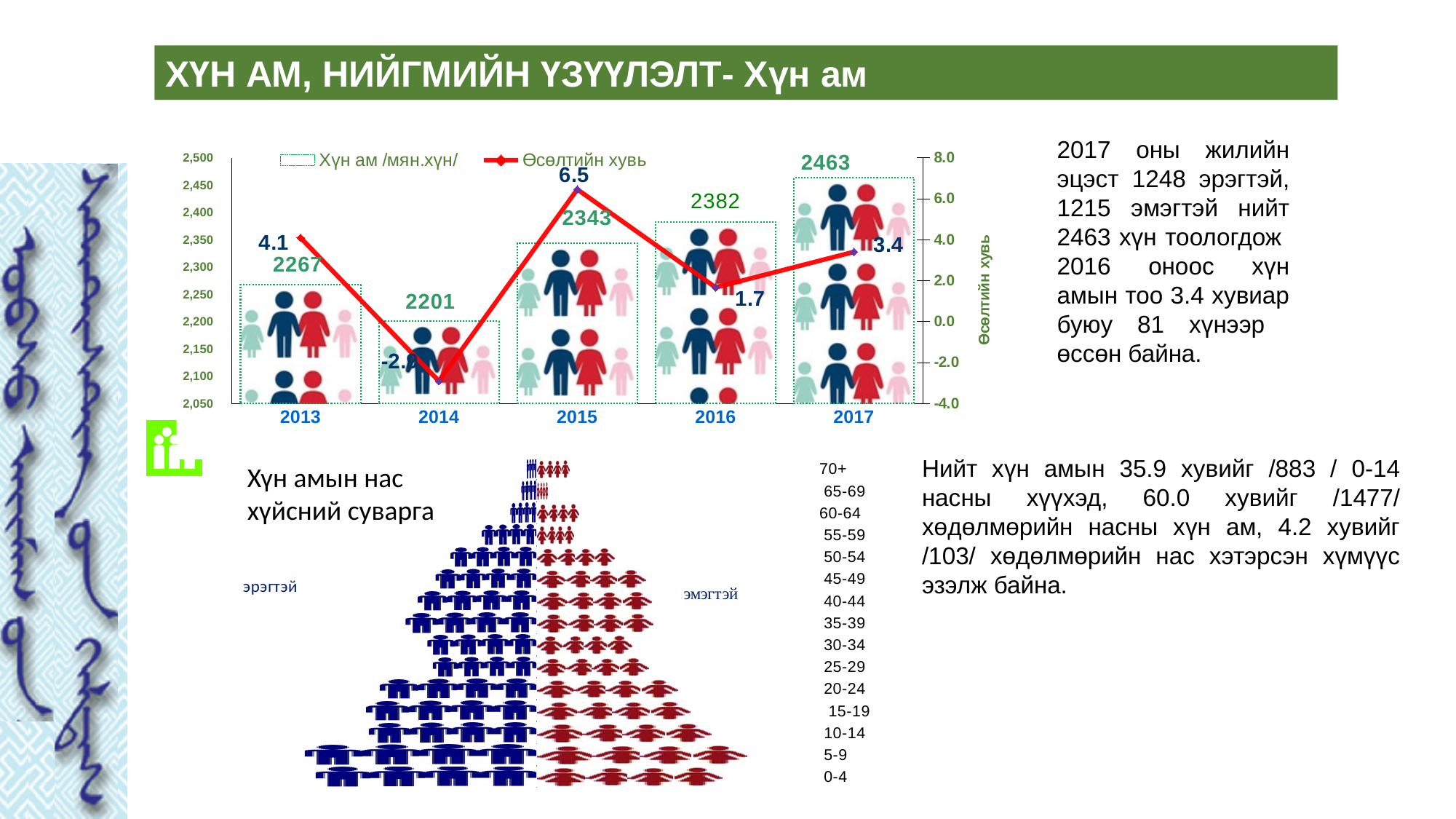
In the top chart, what is the population value for 2014? 2201 How many years are shown on the x axis of the top chart? 5 In the top chart, what is the difference between the population values for 2017 and 2016? 81 In the top chart, which year has the larger population value, 2013 or 2014? 2013 In the top chart, what is the growth rate (Өсөлтийн хувь) for 2015? 6.5 In the top chart, what is the population (Хүн ам /мян.хүн/) value for 2017? 2463 In the top chart, which year has the highest growth rate? 2015 How many series does the legend of the top chart list? 2 In the top chart, which year has the lowest population value? 2014 In the top chart, does the population value rise or fall from 2014 to 2017? rise In the top chart, which year has the highest population value? 2017 In the top chart, what is the growth rate for 2017? 3.4